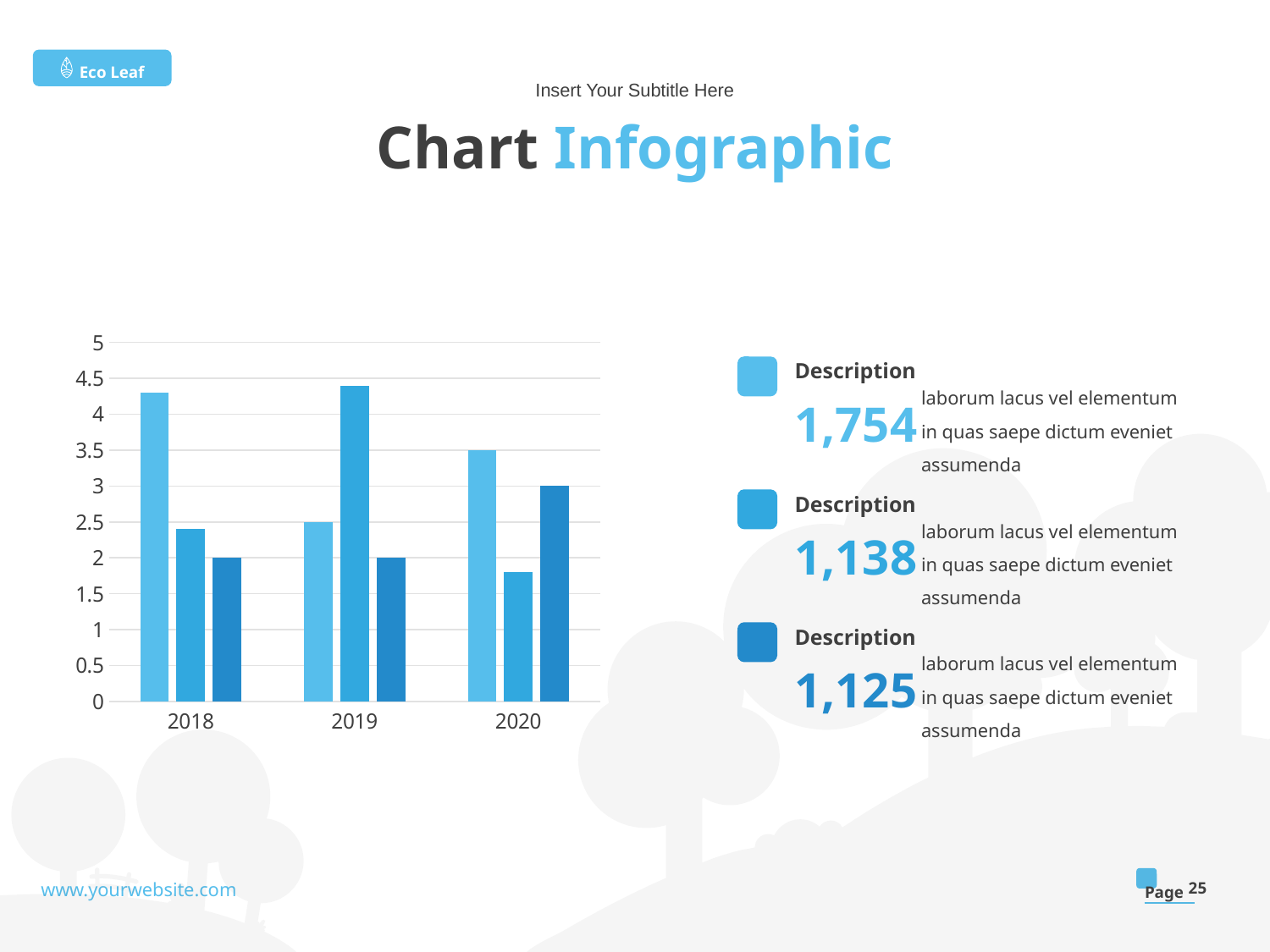
For 2019, which is larger: the lightest blue bar or the medium blue (middle) bar? the medium blue bar What is the value of the darkest blue bar for 2018? 2 What is the value of the darkest blue bar for 2020? 3 How many years are shown on the x axis of the chart? 3 Is the value of the medium blue (middle) bar for 2020 greater or less than 2? less What is the value of the lightest blue bar for 2019? 2.5 Which bar is the tallest in the 2020 group? the lightest blue bar What is the value of the lightest blue bar for 2020? 3.5 How many bars are plotted for each year in the chart? 3 What kind of chart is shown on the slide? bar chart Is the value of the lightest blue bar for 2018 greater or less than 4? greater What is the difference between the lightest blue bar and the darkest blue bar for 2020? 0.5